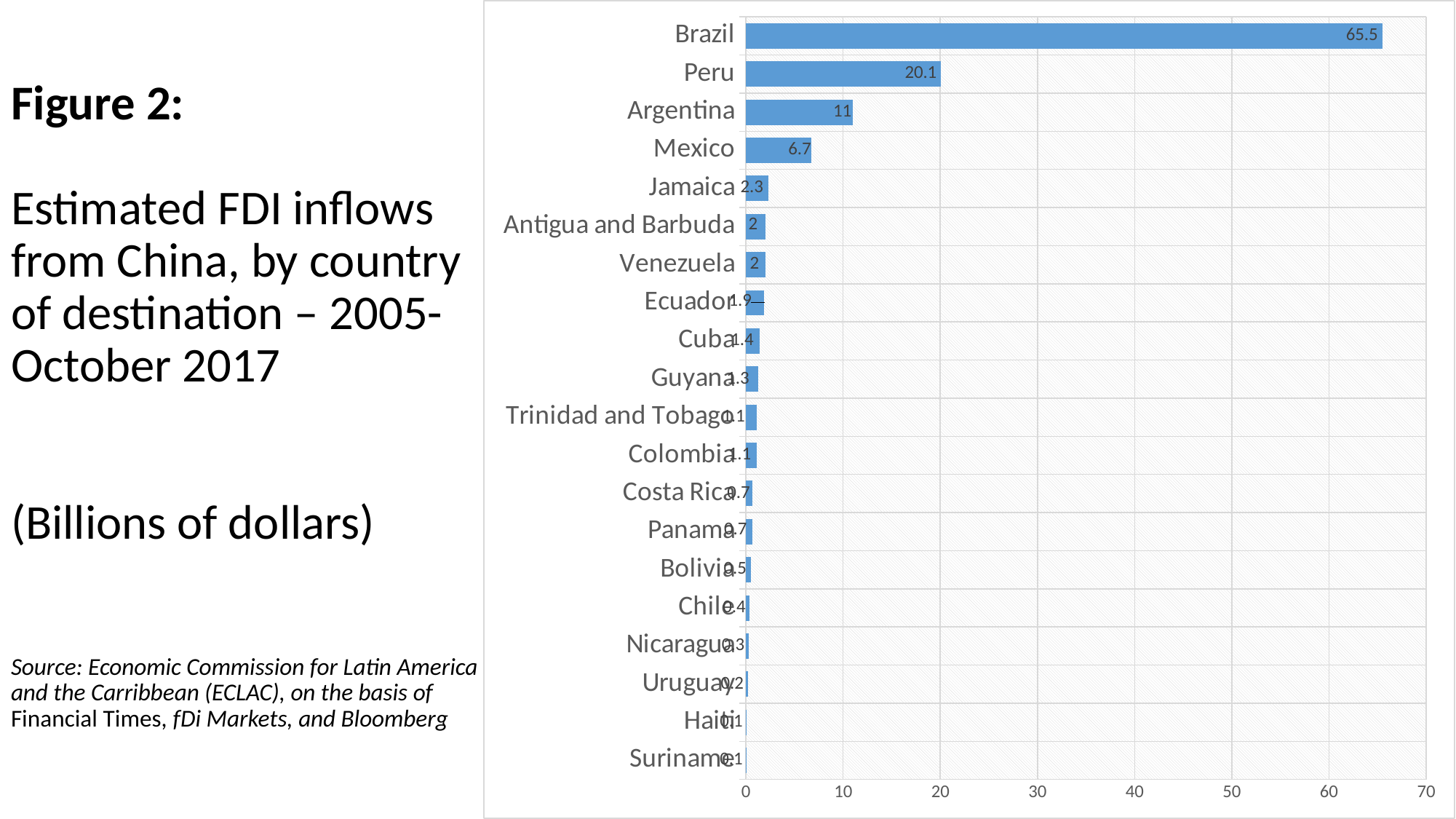
Which has a larger value, Argentina or Mexico? Argentina In what units are the values in the chart expressed? Billions of dollars What is the difference between the values for Brazil and Peru? 45.4 Which country has the highest estimated FDI inflow from China? Brazil What is the value shown for Mexico? 6.7 What is the value shown for Jamaica? 2.3 What is the value shown for Peru? 20.1 What kind of chart is shown on the slide? Bar chart What is the estimated FDI inflow value for Brazil? 65.5 How many countries are shown in the chart? 20 Is the value for Brazil greater or less than 60? greater What is the value shown for Argentina? 11